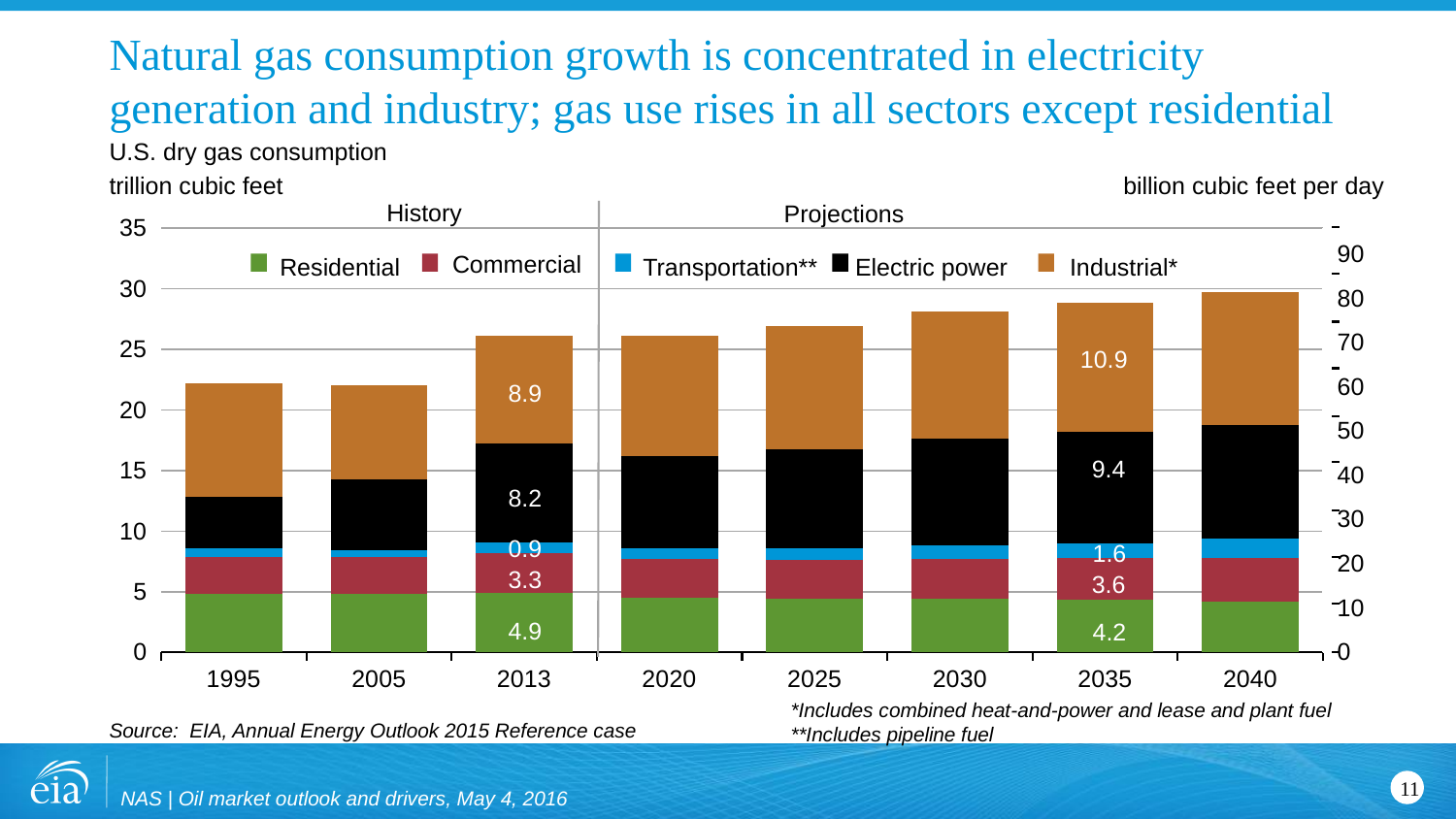
What is the total of the stacked bar for 2035? 29.7 What is the Electric power value for 2035? 9.4 What is the Transportation** value for 2035? 1.6 How many years are shown on the x axis? 8 By how much does the Industrial* value in 2035 exceed the Industrial* value in 2013? 2.0 What is the total of the stacked bar for 2013? 26.2 In 2035, which is larger: the Industrial* value or the Electric power value? Industrial* What is the Residential value for 2013? 4.9 Is the total for 1995 greater or less than 20 trillion cubic feet? greater Which year has the highest total consumption? 2040 How many series does the legend list? 5 What is the Industrial* value for 2013? 8.9